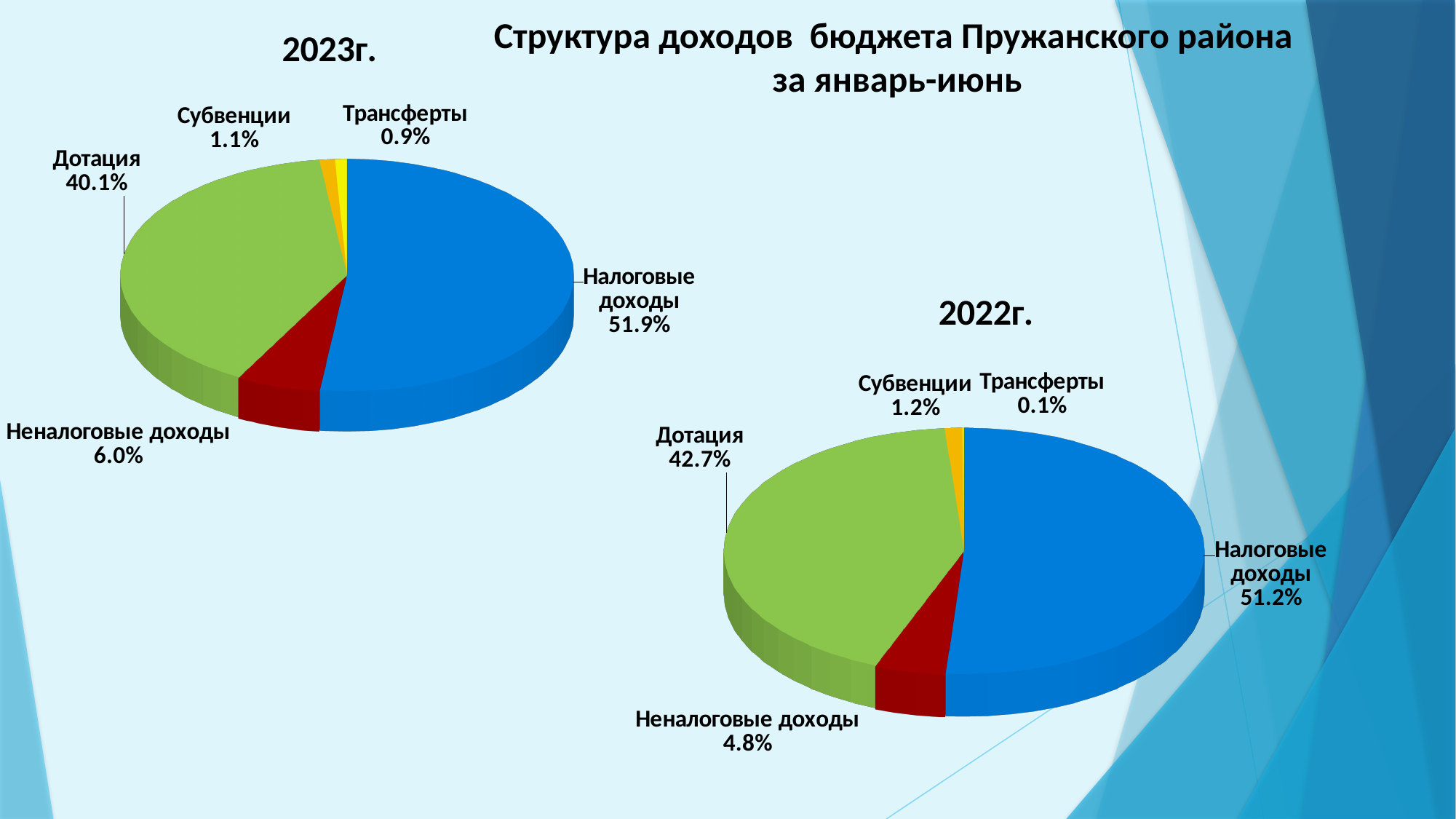
In the 2023г. pie chart, what share is Неналоговые доходы? 6.0% In the 2022г. pie chart, what share is Дотация? 42.7% Which is larger: Неналоговые доходы in 2023г. or in 2022г.? 2023г. In the 2022г. pie chart, what share is Трансферты? 0.1% In the 2023г. pie chart, what share is Налоговые доходы? 51.9% In the 2022г. pie chart, which category has the smallest share? Трансферты What type of chart is used for the 2023г. data? Pie chart What is the difference between the Дотация share in 2022г. and in 2023г.? 2.6% In the 2023г. pie chart, which category has the smallest share? Трансферты What colour is the Дотация slice in the 2023г. pie chart? Green In the 2023г. pie chart, which category has the largest share? Налоговые доходы How many categories does the 2022г. pie chart show? 5